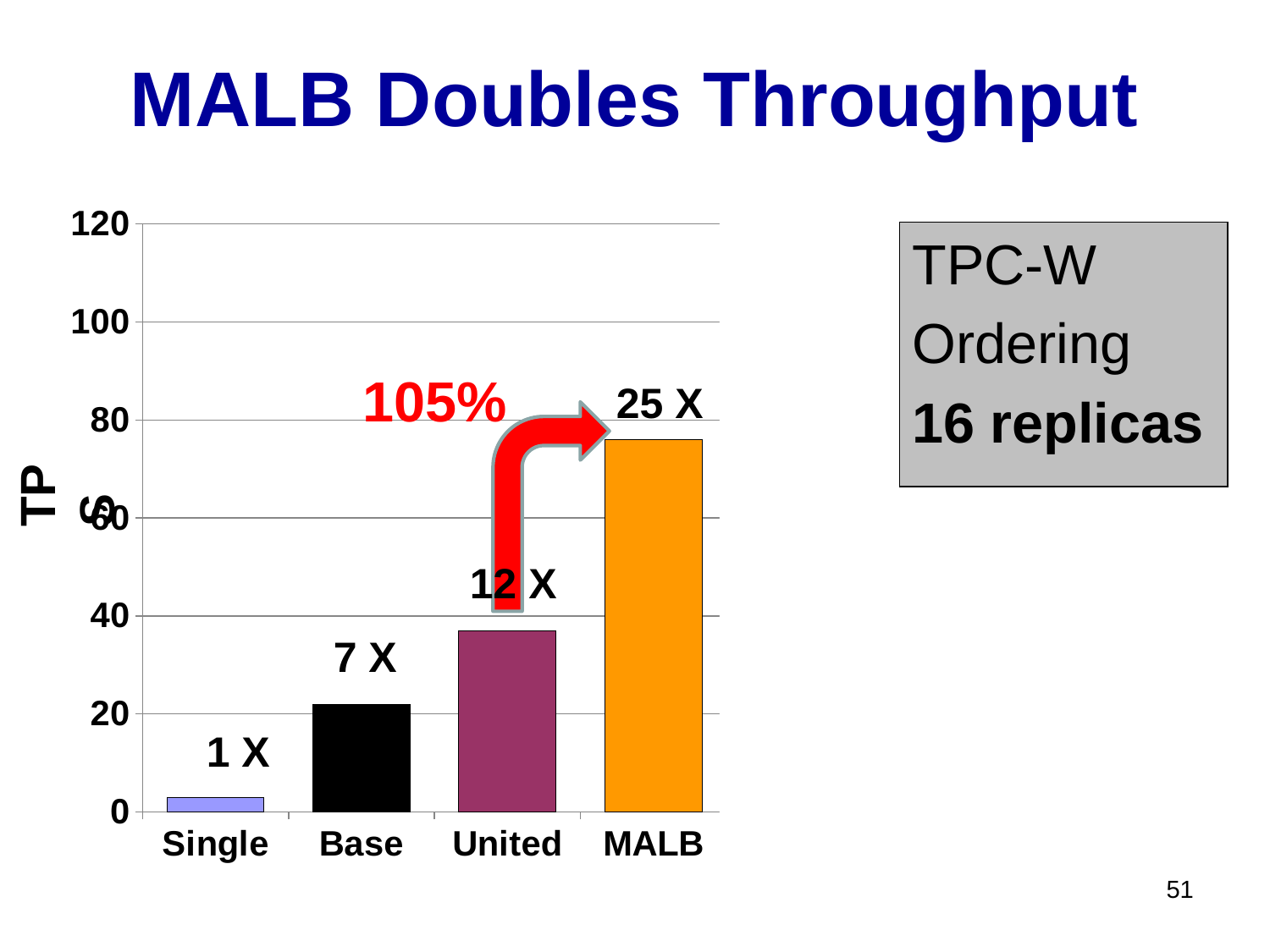
Which category has the lowest bar in the chart? Single What kind of chart is shown on the slide? bar chart Which bar is taller, United or Base? United What label is printed above the Base bar? 7 X How many categories are shown on the x axis of the chart? 4 Which category has the highest bar in the chart? MALB What label is printed above the MALB bar? 25 X Is the value for MALB greater or less than 60? greater Do the bar values rise or fall from Single to MALB along the x axis? rise Is the value for Base greater or less than 40? less Is the value for United greater or less than 60? less